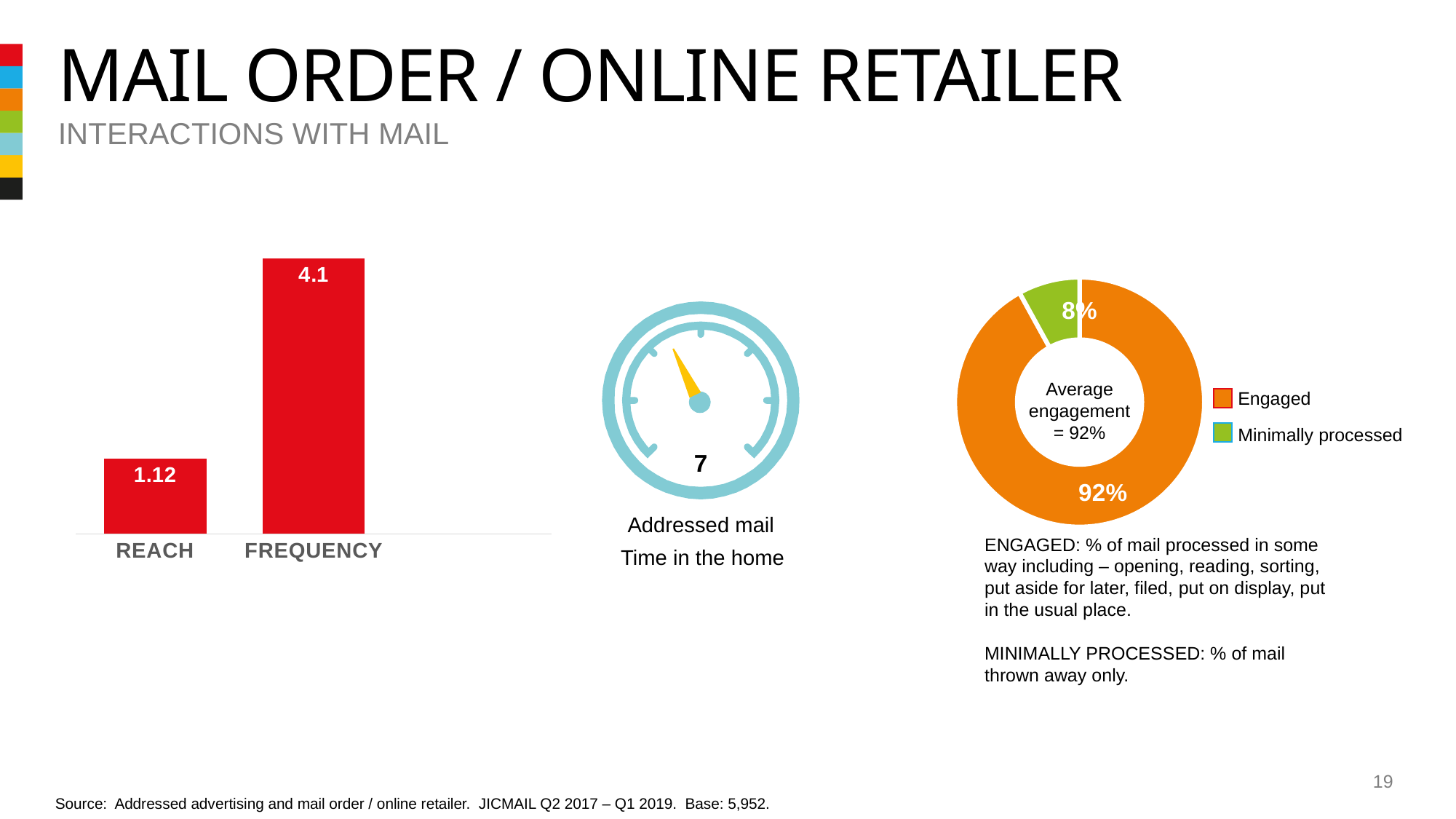
In the bar chart on the left, what is the value for FREQUENCY? 4.1 In the bar chart on the left, which category has the lower value? REACH In the donut chart on the right, what colour is the Minimally processed segment? Green In the bar chart on the left, what is the difference between the FREQUENCY value and the REACH value? 2.98 In the bar chart on the left, which category has the higher value? FREQUENCY In the donut chart on the right, which segment is larger, Engaged or Minimally processed? Engaged In the donut chart on the right, what share is labelled Engaged? 92% In the donut chart on the right, what share is labelled Minimally processed? 8% In the bar chart on the left, what is the value for REACH? 1.12 What kind of chart is the chart on the left of the slide? Bar chart How many entries does the legend of the donut chart on the right list? 2 In the bar chart on the left, how many categories are shown? 2